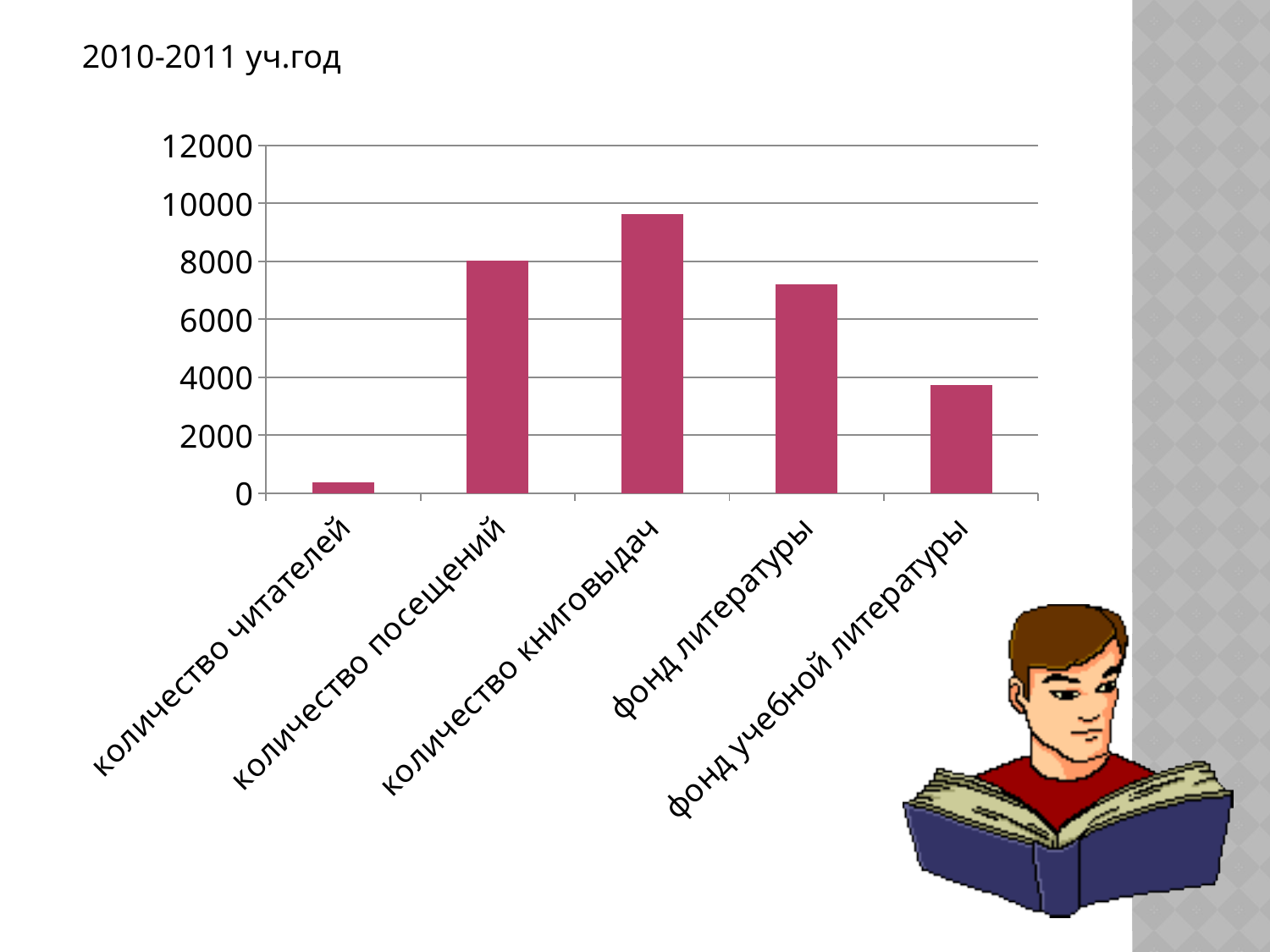
What is the title shown above the chart? 2010-2011 уч.год Which category has the lowest value? количество читателей Is the value for фонд литературы greater or less than 8000? less How many categories are plotted on the chart? 5 Which is larger: фонд литературы or фонд учебной литературы? фонд литературы Is the value for количество читателей greater or less than 2000? less Which is larger: количество посещений or фонд литературы? количество посещений What kind of chart is shown on the slide? bar chart What is the highest value shown on the vertical axis? 12000 Which category has the highest value? количество книговыдач Is the value for фонд учебной литературы greater or less than 4000? less